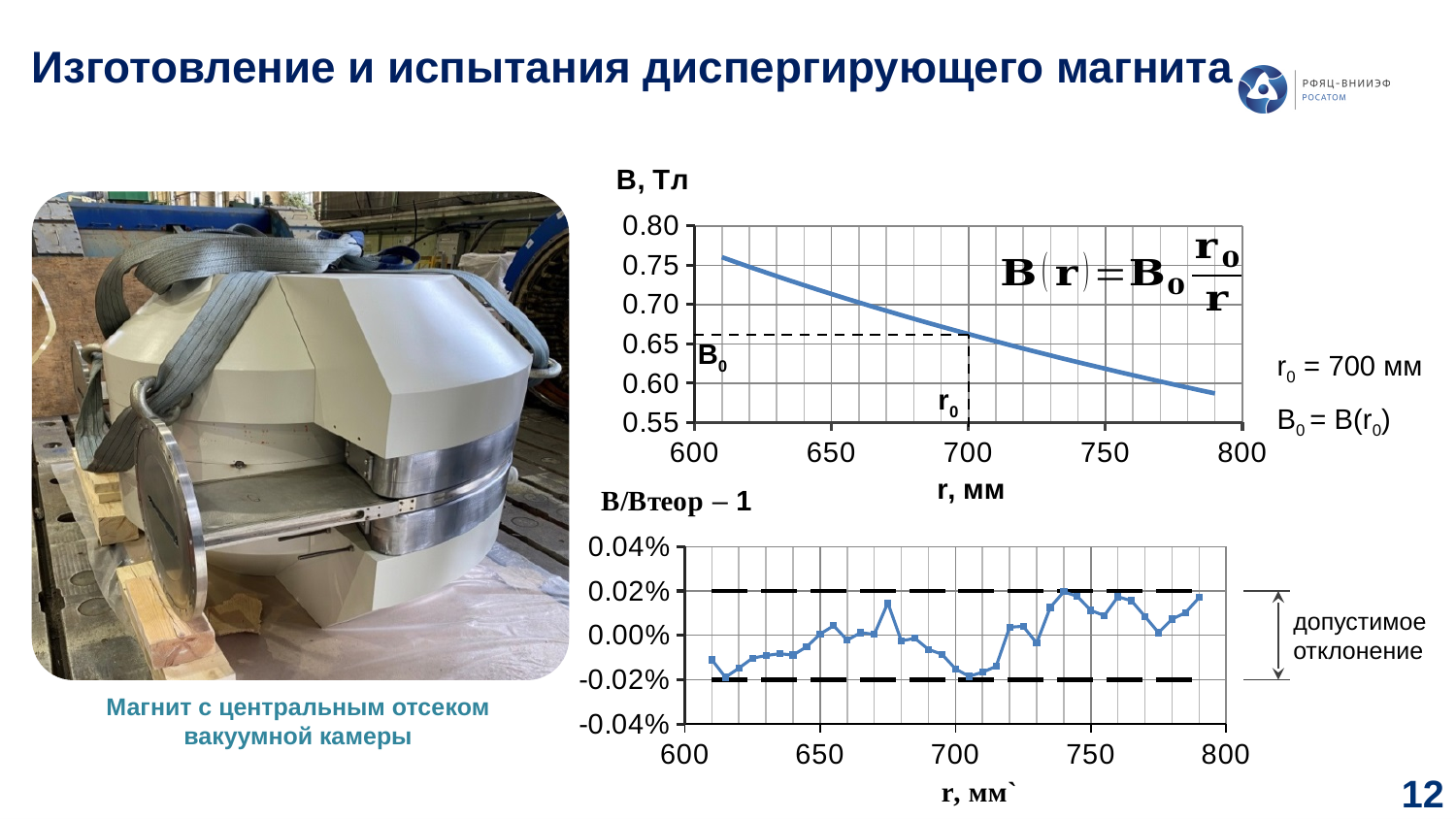
In the bottom chart (B/Bтеор − 1), at what levels are the two dashed lines marking the допустимое отклонение drawn? 0.02% and -0.02% What kind of chart is the bottom chart (B/Bтеор − 1 versus r, мм)? line chart In the top chart (B, Тл), is the value of B at the left end of the curve (near r = 610 мм) greater or less than 0.70? greater In the top chart (B, Тл), is the value of B at r = 700 мм greater or less than 0.70? less According to the text next to the top chart, what is the value of r0? 700 мм What kind of chart is the top chart (B, Тл versus r, мм)? line chart In the bottom chart (B/Bтеор − 1), is the value at the first point (near r = 610 мм) greater or less than 0.00%? less In the bottom chart (B/Bтеор − 1), what is the lowest value shown on the vertical axis? -0.04% In the top chart (B, Тл), what is the highest value shown on the vertical axis? 0.80 In the top chart (B, Тл), does the value of B rise or fall as r increases from 600 to 800 мм? fall